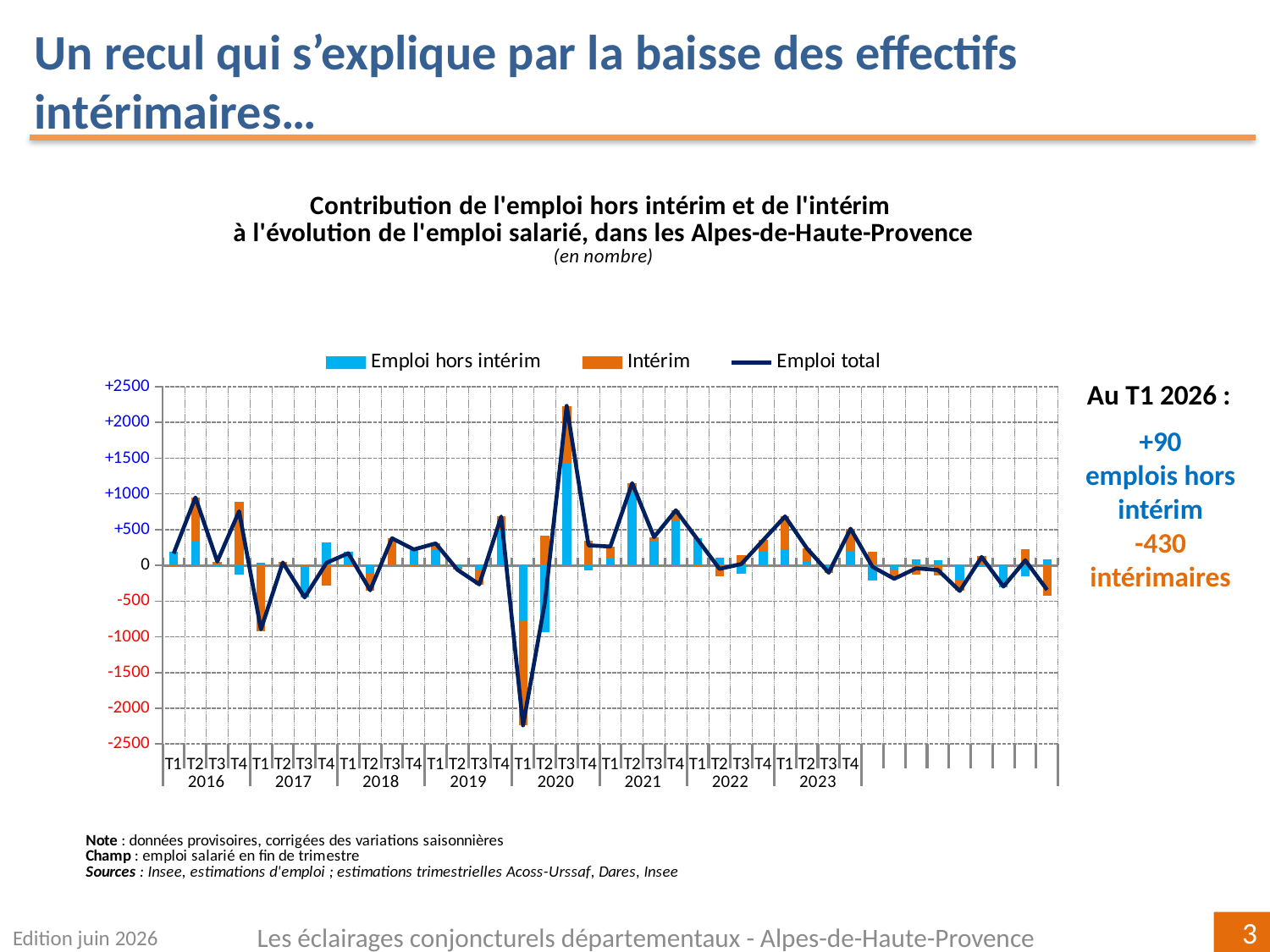
Between T1 2020 and T3 2020, does the Emploi total line rise or fall? Rise What kind of chart is shown on the slide? A combined bar and line chart How many series does the chart legend list? 3 What is the title of the chart? Contribution de l'emploi hors intérim et de l'intérim à l'évolution de l'emploi salarié, dans les Alpes-de-Haute-Provence In which quarter does the Emploi total line reach its highest value? T3 2020 Is the Emploi total value for T1 2017 greater or less than -500? less Is the Emploi total value for T1 2020 greater or less than -2000? less Is the Emploi total value for T3 2020 greater or less than +2000? greater Which is larger, the Emploi total value for T3 2020 or for T2 2021? T3 2020 According to the slide, what is the contribution of emploi hors intérim at T1 2026? +90 In which quarter does the Emploi total line reach its lowest value? T1 2020 What colour are the Intérim bars in the chart? Orange